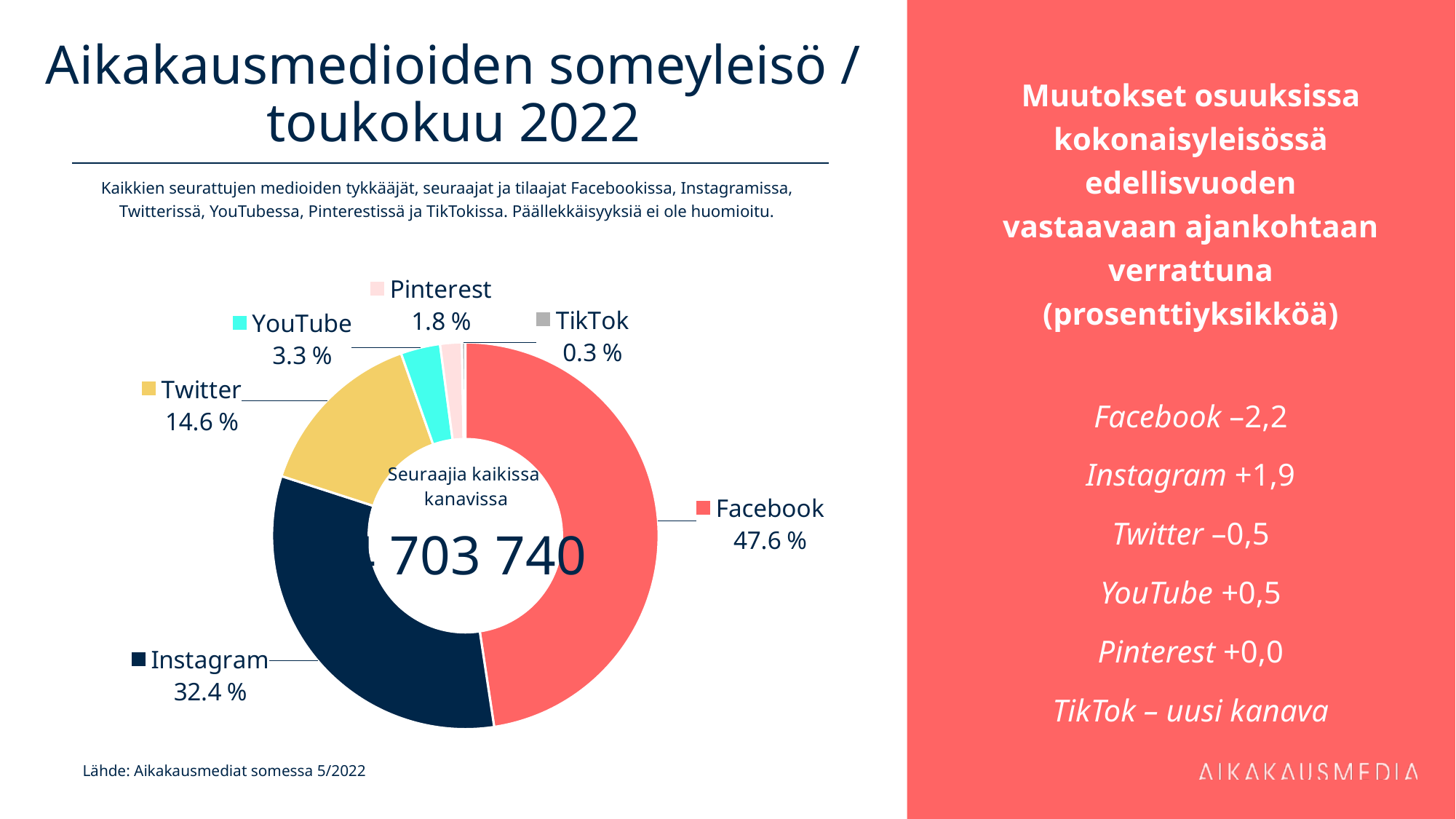
What share does Instagram hold in the donut chart? 32.4 % How many percentage points larger is Facebook's share than Instagram's share? 15.2 What share is shown for TikTok in the donut chart? 0.3 % What is the combined share of Pinterest and YouTube in the donut chart? 5.1 % What is the share shown for Twitter in the donut chart? 14.6 % How many channels are shown as slices in the donut chart? 6 Which channel has the largest share in the donut chart? Facebook What type of chart is used on the slide? Donut (pie) chart What share of the social media audience does Facebook hold according to the donut chart? 47.6 % What share is shown for YouTube in the donut chart? 3.3 % Which has a larger share in the donut chart, Twitter or YouTube? Twitter Which channel has the smallest share in the donut chart? TikTok